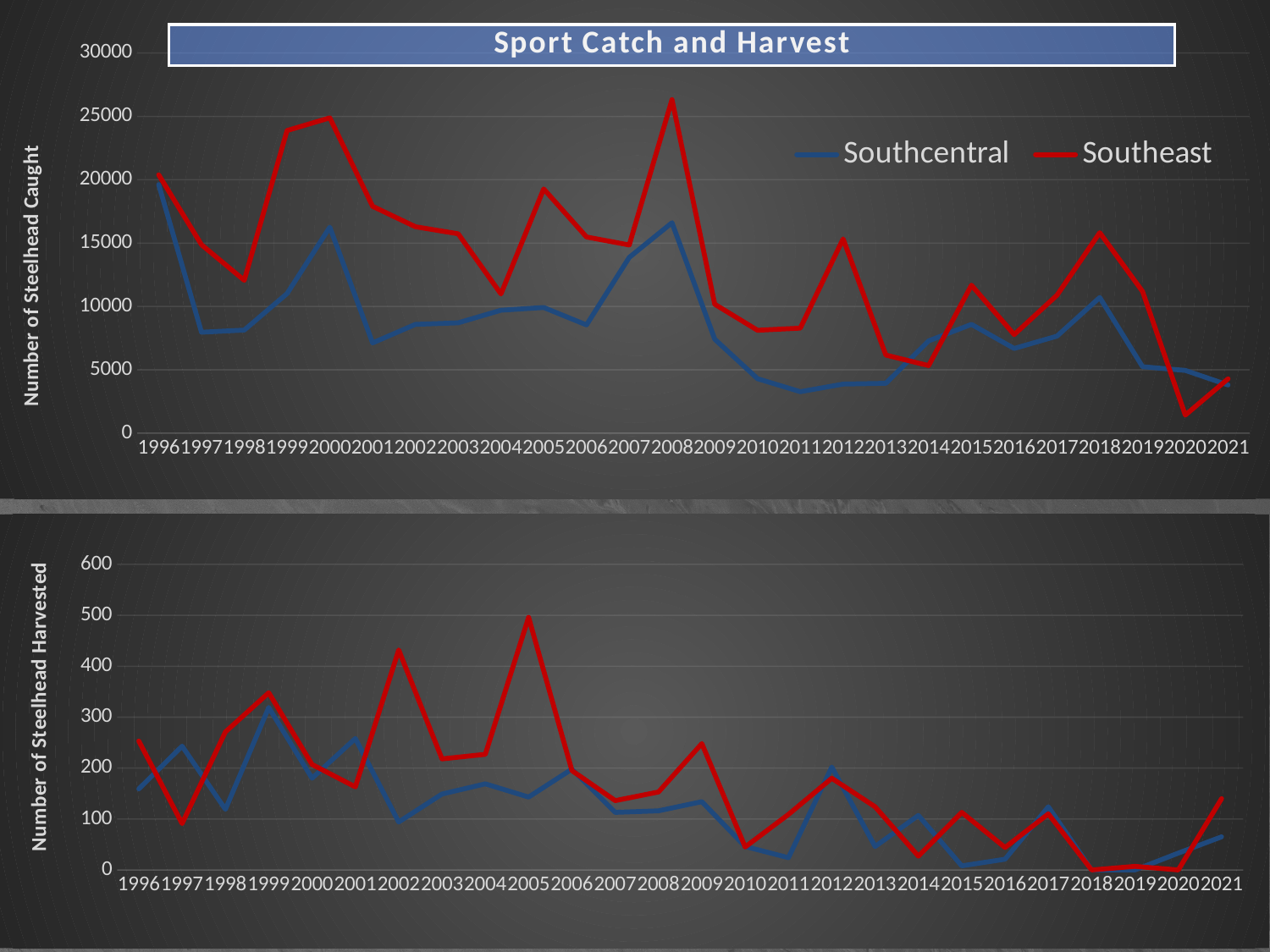
What kind of chart is the top chart titled 'Sport Catch and Harvest'? Line chart In the top chart (Number of Steelhead Caught), in which year does the Southeast series reach its highest value? 2008 In the top chart (Number of Steelhead Caught), in which year does the Southeast series reach its lowest value? 2020 How many series does the legend of the top chart list? 2 In the top chart (Number of Steelhead Caught), is the Southcentral value for 2011 greater or less than 5000? less How many years are shown on the x axis of the top chart? 26 In the top chart (Number of Steelhead Caught), in which year does the Southcentral series reach its highest value? 1996 In the top chart (Number of Steelhead Caught), is the Southeast value for 2008 greater or less than 25000? greater In the top chart (Number of Steelhead Caught), which series has the larger value in 2008, Southcentral or Southeast? Southeast